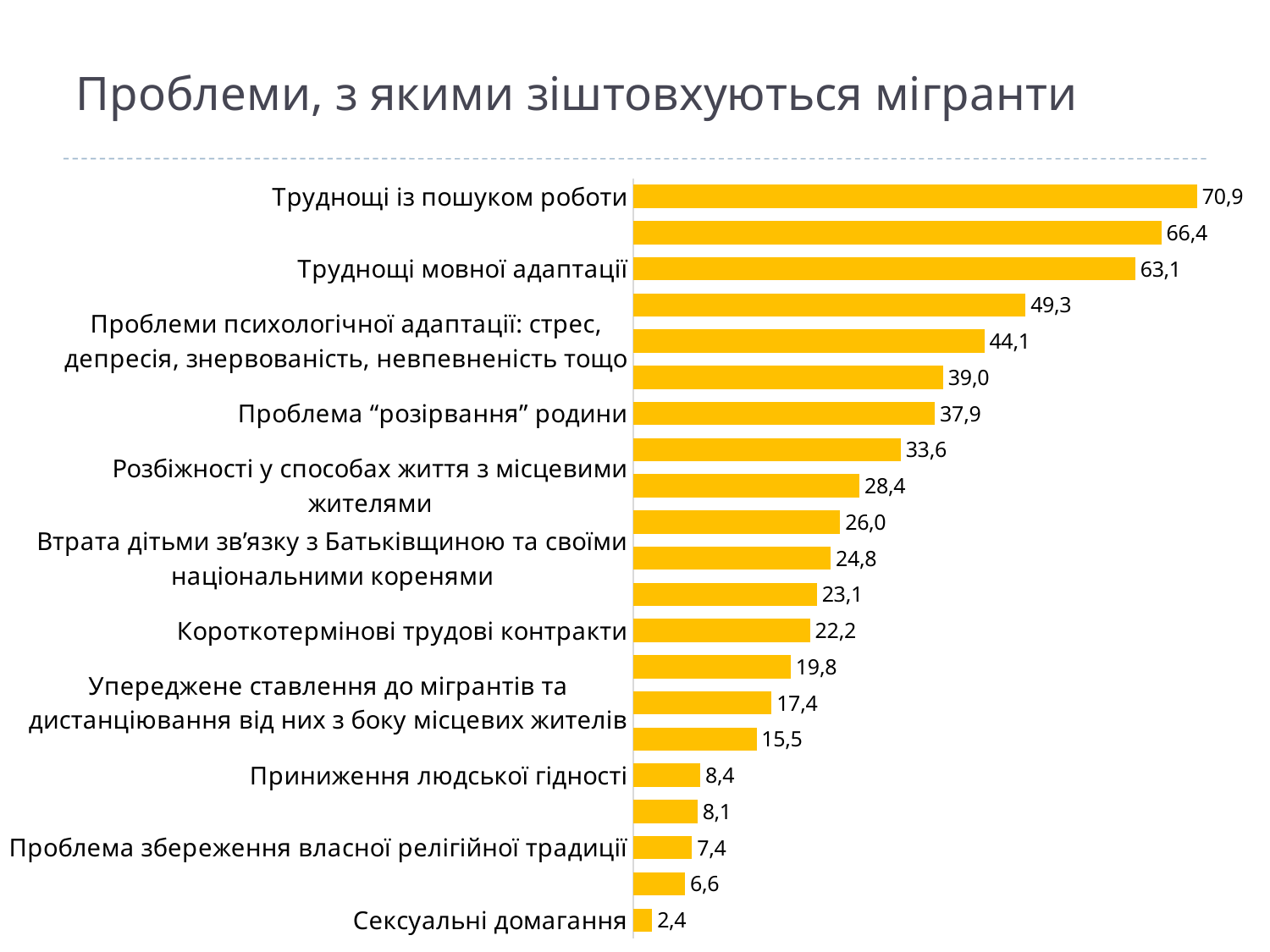
What kind of chart is shown on the slide? Bar chart What is the value for "Труднощі із пошуком роботи"? 70,9 What is the value for "Проблема “розірвання” родини"? 37,9 Which category has the lowest value? Сексуальні домагання What is the difference between the values for "Труднощі із пошуком роботи" and "Труднощі мовної адаптації"? 7,8 What is the value for "Труднощі мовної адаптації"? 63,1 Which category has the highest value? Труднощі із пошуком роботи What is the value for "Короткотермінові трудові контракти"? 22,2 What is the title of the slide? Проблеми, з якими зіштовхуються мігранти Which is larger: the value for "Приниження людської гідності" or for "Проблема збереження власної релігійної традиції"? Приниження людської гідності What is the value for "Сексуальні домагання"? 2,4 How many bars are plotted in the chart? 21